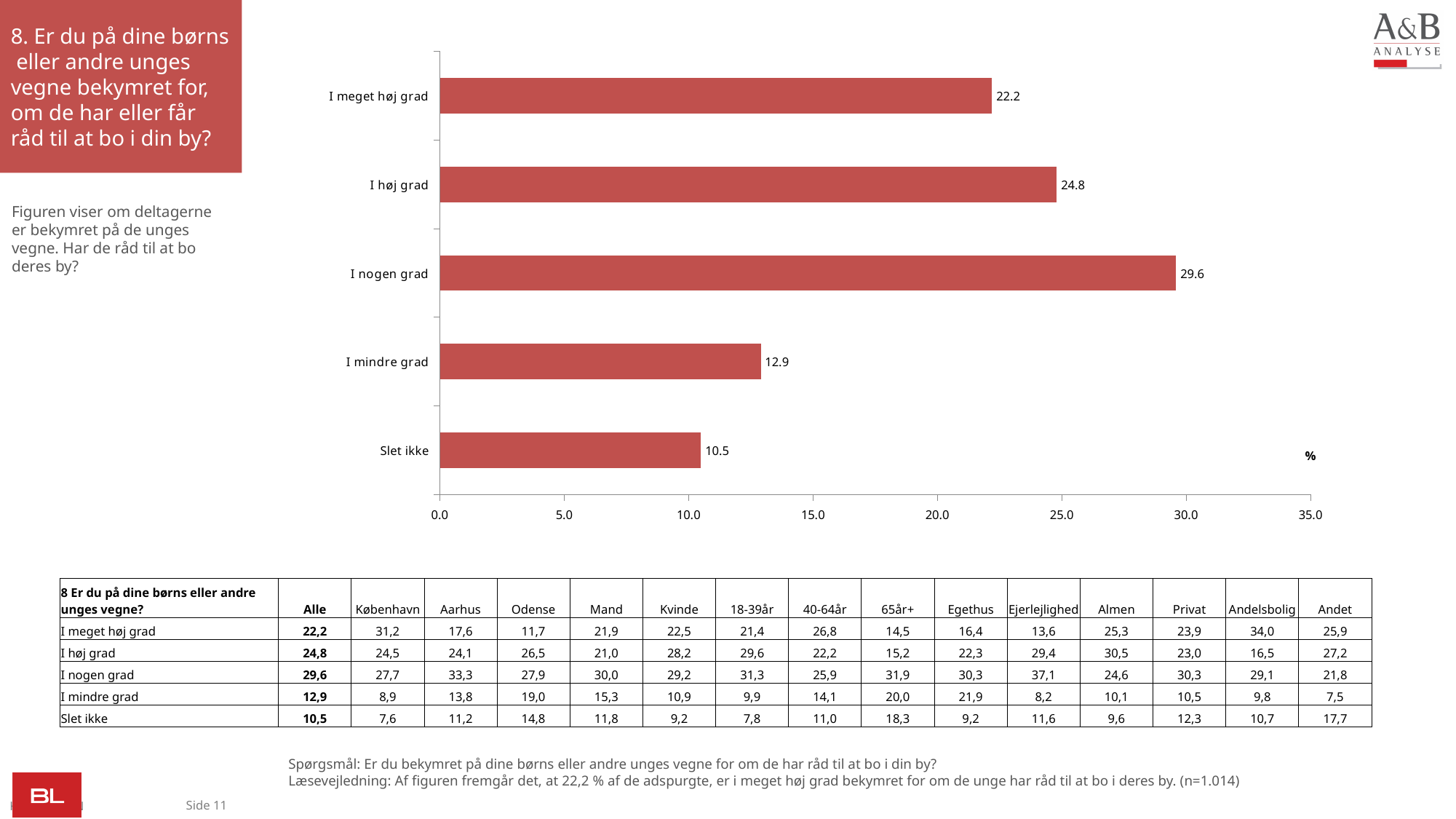
What is the value for "I nogen grad"? 29.6 What is the maximum value shown on the horizontal axis? 35.0 What is the value for "Slet ikke"? 10.5 What is the difference between the values for "I høj grad" and "I meget høj grad"? 2.6 Which is larger, the value for "I meget høj grad" or the value for "I mindre grad"? I meget høj grad Which category has the lowest value? Slet ikke What is the value for "I høj grad"? 24.8 What is the difference between the values for "I nogen grad" and "I mindre grad"? 16.7 How many categories are shown in the chart? 5 Is the value for "I høj grad" greater or less than 20.0? greater What kind of chart is shown on the slide? bar chart Which category has the highest value? I nogen grad